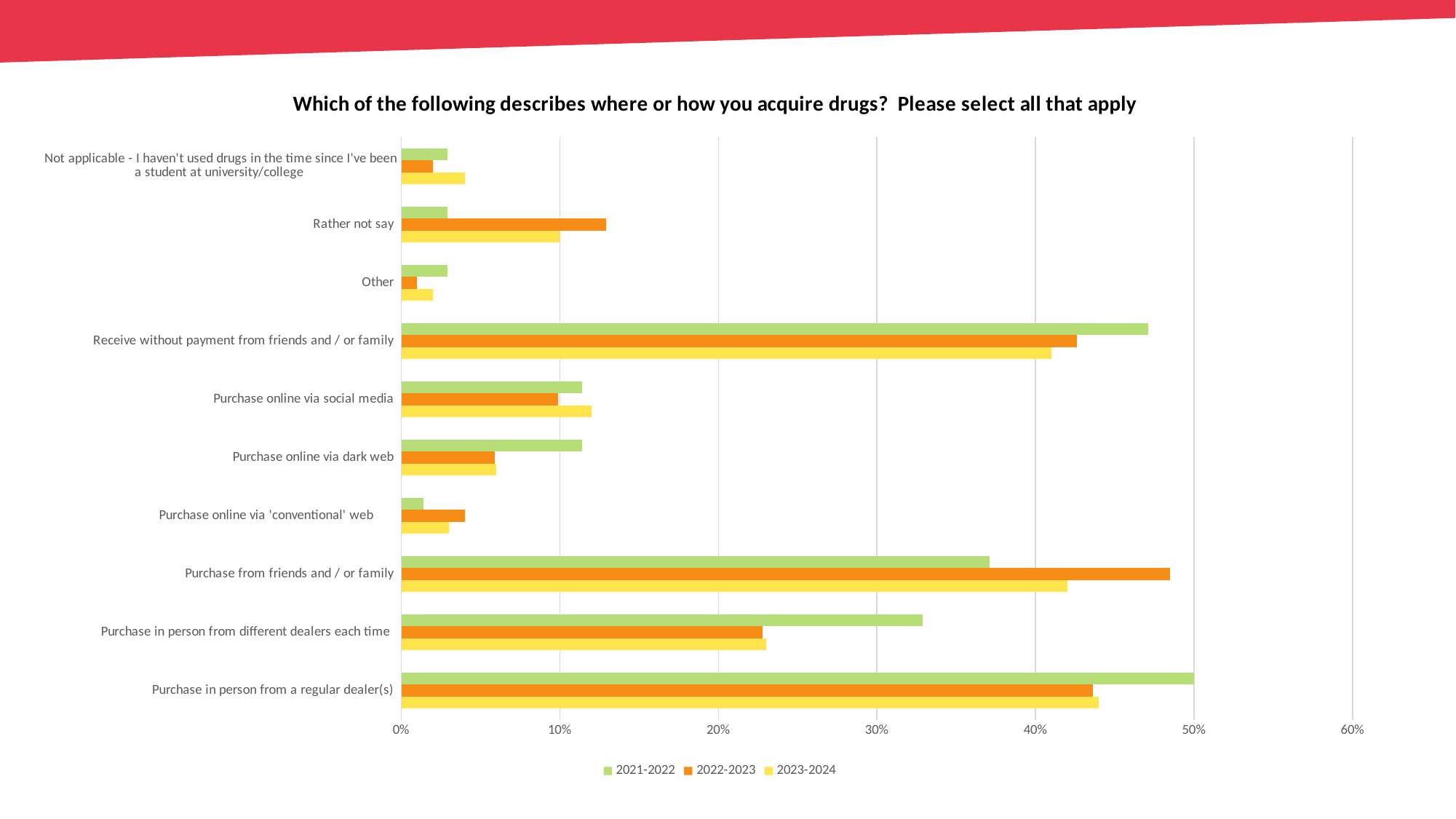
How many categories are plotted on the chart? 10 Which category has the highest value for the 2021-2022 series? Purchase in person from a regular dealer(s) Which category has the highest value for the 2022-2023 series? Purchase from friends and / or family Is the 2022-2023 value for 'Purchase online via dark web' greater or less than 10%? less For 'Receive without payment from friends and / or family', which series has the larger value: 2021-2022 or 2023-2024? 2021-2022 What is the title of the chart? Which of the following describes where or how you acquire drugs? Please select all that apply What kind of chart is shown on the slide? Bar chart How many series does the legend list? 3 For 'Purchase from friends and / or family', which series has the larger value: 2021-2022 or 2022-2023? 2022-2023 Is the 2021-2022 value for 'Purchase in person from different dealers each time' greater or less than 30%? greater Which category has the lowest value for the 2022-2023 series? Other Is the 2022-2023 value for 'Purchase from friends and / or family' greater or less than 40%? greater